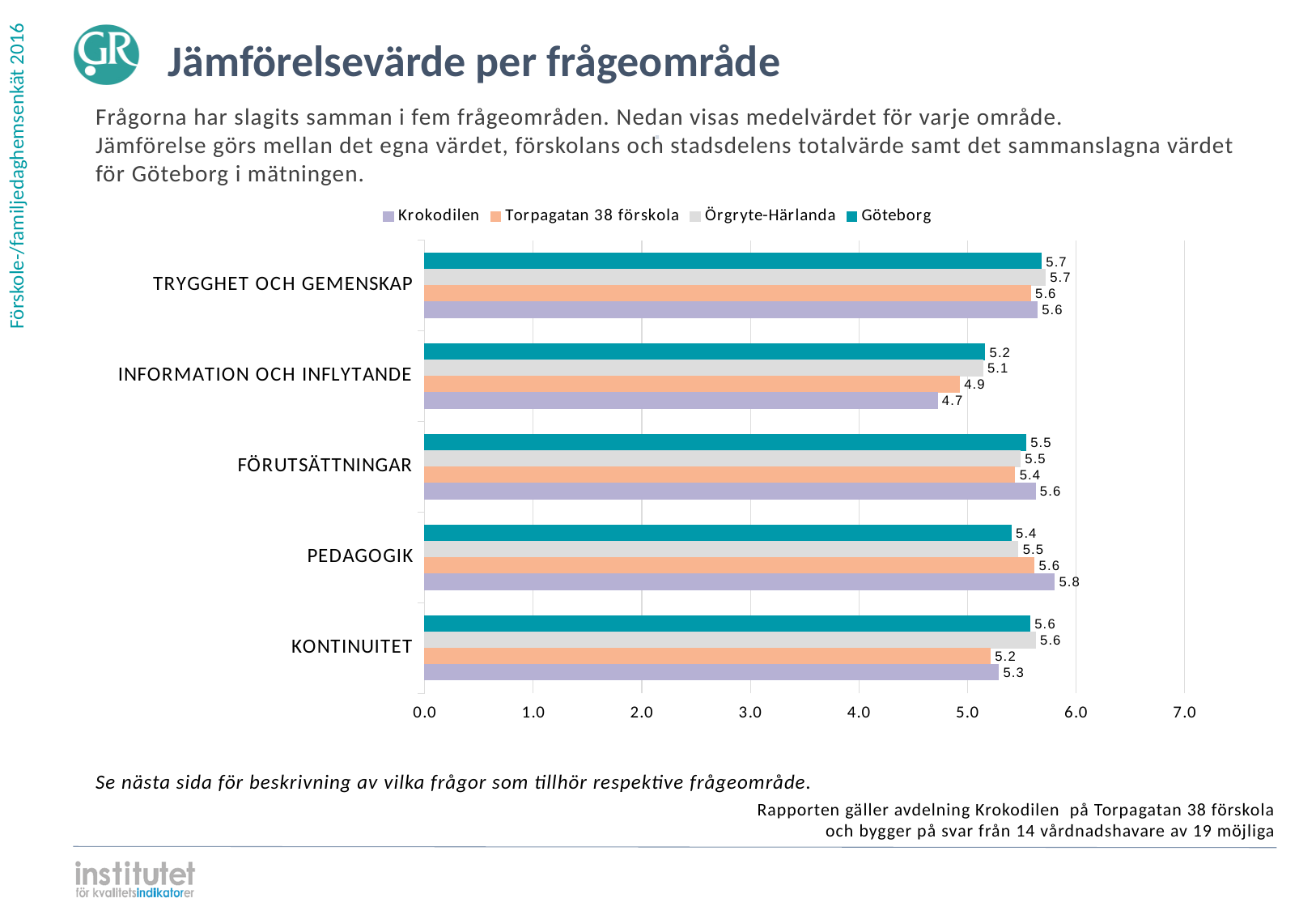
What kind of chart is shown on the slide? bar chart What is the value for Torpagatan 38 förskola in KONTINUITET? 5.2 What is the value for Krokodilen in PEDAGOGIK? 5.8 What is the value for Göteborg in INFORMATION OCH INFLYTANDE? 5.2 In which question area does Krokodilen have its highest value? PEDAGOGIK How many series does the legend list? 4 What is the value for Örgryte-Härlanda in FÖRUTSÄTTNINGAR? 5.5 In which question area does Krokodilen have its lowest value? INFORMATION OCH INFLYTANDE How many question areas (categories) are shown on the chart? 5 What is the difference between the Göteborg value and the Krokodilen value in INFORMATION OCH INFLYTANDE? 0.5 Which is larger in KONTINUITET: the value for Krokodilen or the value for Göteborg? Göteborg Which series is shown in teal (dark green) on the chart? Göteborg